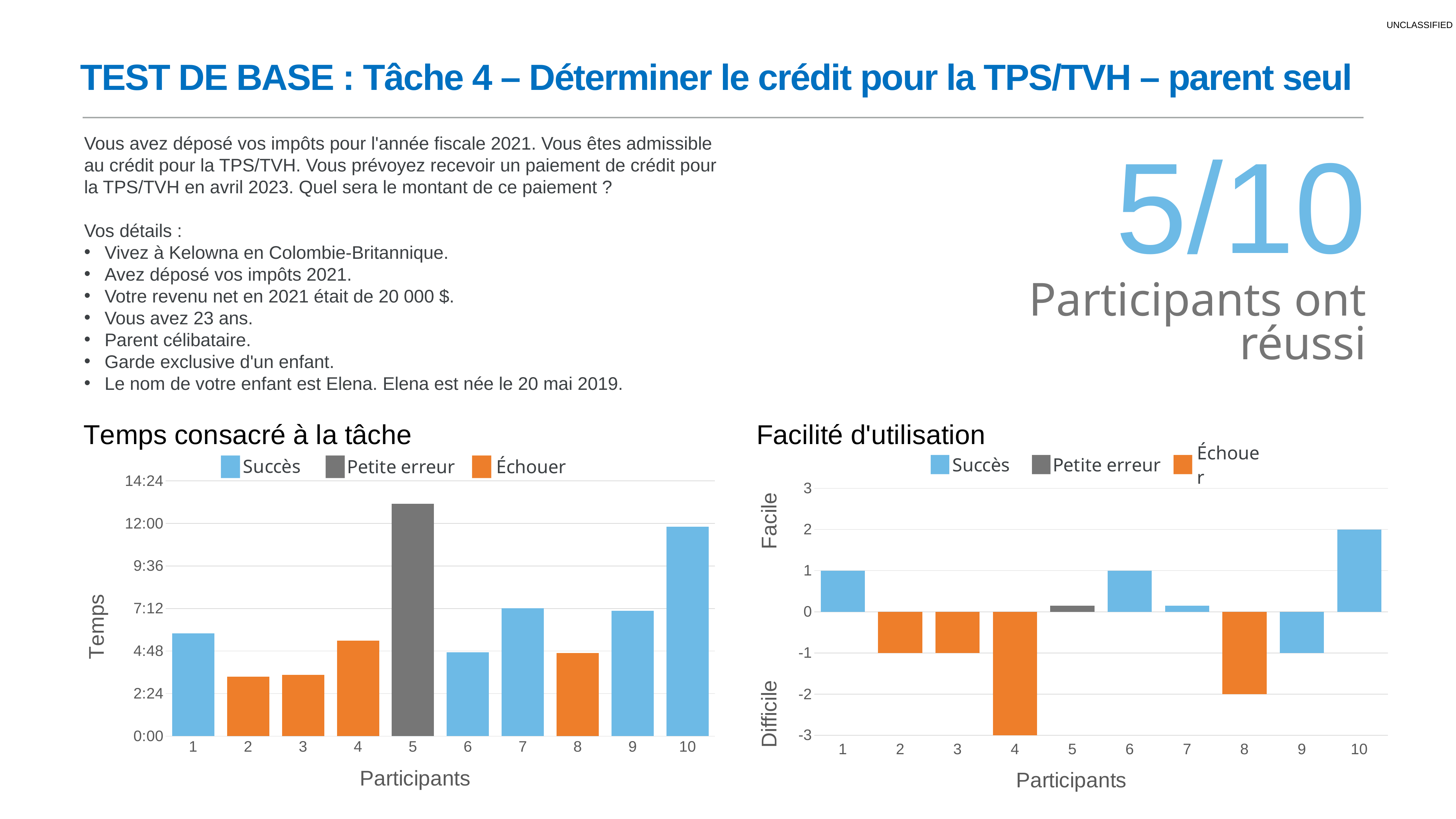
In the "Temps consacré à la tâche" chart, is the value for participant 5 greater or less than 12:00? greater In the "Temps consacré à la tâche" chart, is the value for participant 2 greater or less than 4:48? less In the "Facilité d'utilisation" chart, what is the difference between the values for participant 10 and participant 4? 5 In the "Facilité d'utilisation" chart, which is larger, the value for participant 1 or participant 8? participant 1 In the "Temps consacré à la tâche" chart, which participant has the highest time? 5 In the "Facilité d'utilisation" chart, which participant has the lowest value? 4 What kind of chart is "Temps consacré à la tâche"? bar chart In the "Facilité d'utilisation" chart, what is the value for participant 4? -3 How many participants are shown on the x axis of the "Temps consacré à la tâche" chart? 10 How many series does the legend of the "Facilité d'utilisation" chart list? 3 In the "Temps consacré à la tâche" chart, which series is shown in orange according to the legend? Échouer In the "Facilité d'utilisation" chart, what is the value for participant 10? 2